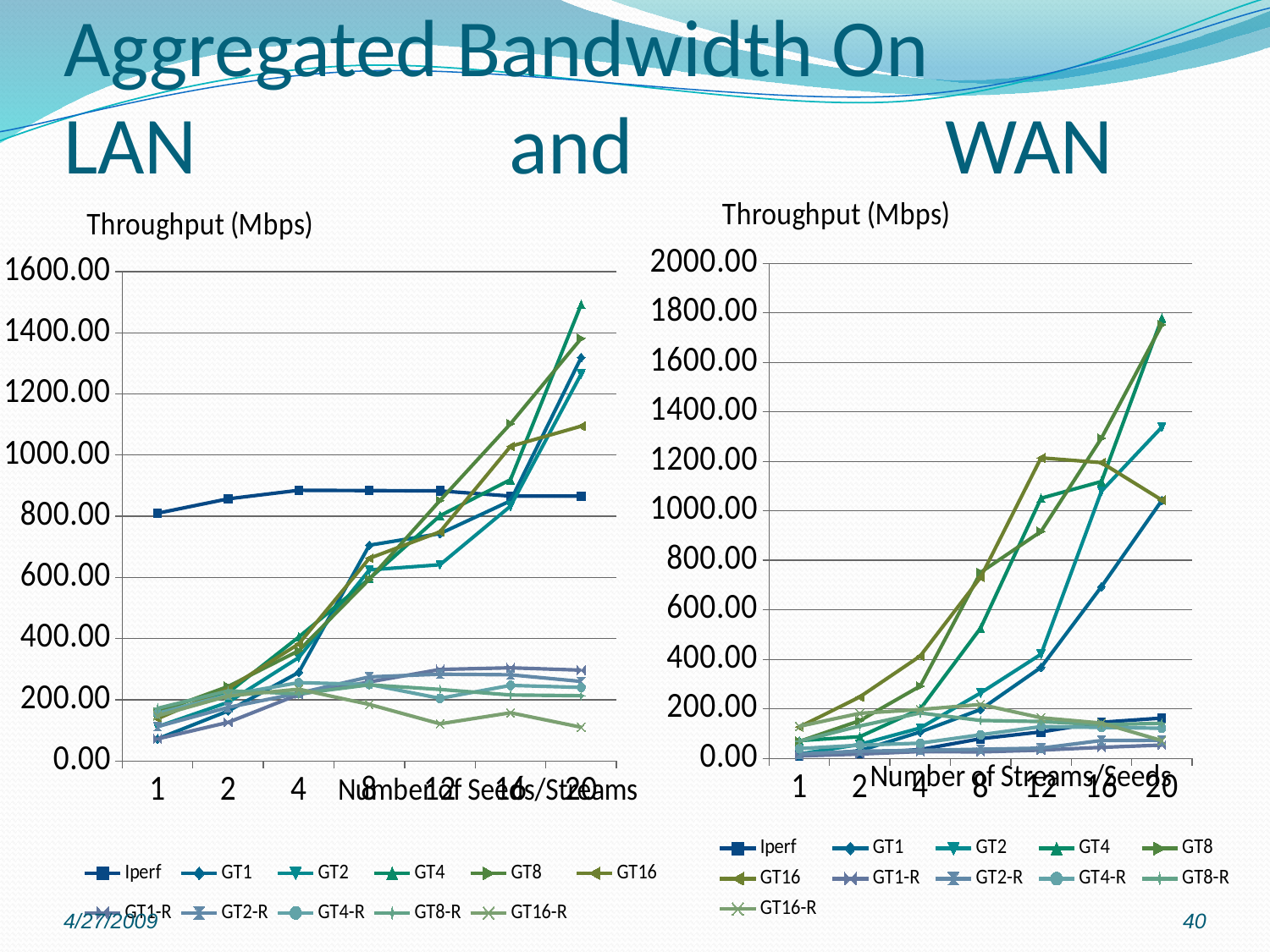
On the LAN chart on the left, which series has the highest value at 20 streams? GT4 What kind of chart is the LAN chart on the left? line chart On the LAN chart on the left, which series has the lowest value at 20 streams? GT16-R On the WAN chart on the right, is the value for Iperf at 20 streams greater or less than 200? less On the WAN chart on the right, is the value for GT2 at 20 streams greater or less than 1200? greater On the LAN chart on the left, is the value for GT4 at 20 streams greater or less than 1400? greater On the WAN chart on the right, which is larger at 12 streams, GT8 or Iperf? GT8 What is the y-axis label of the WAN chart on the right? Throughput (Mbps) How many points along the x axis does the LAN chart on the left have? 7 On the WAN chart on the right, does the GT4 series rise or fall from 1 to 20 streams? rise How many series does the legend of the WAN chart on the right list? 11